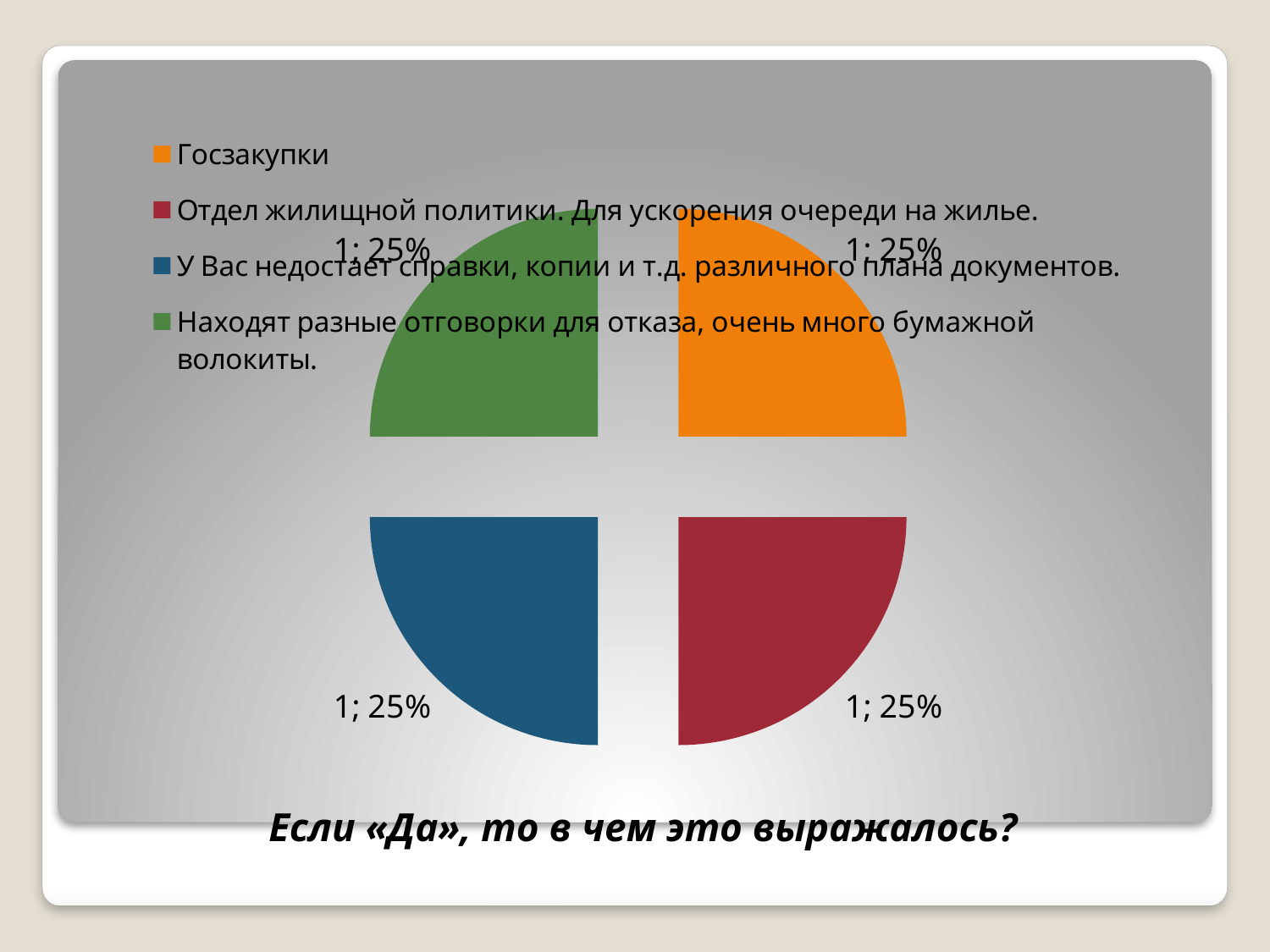
What value is printed on the data label for the «Находят разные отговорки для отказа, очень много бумажной волокиты.» slice? 1; 25% What is the title shown below the pie chart? Если «Да», то в чем это выражалось? What share of the pie does the slice for «У Вас недостает справки, копии и т.д. различного плана документов.» represent? 25% What kind of chart is shown on the slide? pie chart What share of the pie does the slice for Госзакупки represent? 25% What is the total of the values across all four slices of the pie chart? 4 How many slices does the pie chart have? 4 What value is printed on the data label for the Госзакупки slice? 1; 25% What share of the pie does the slice for «Находят разные отговорки для отказа, очень много бумажной волокиты.» represent? 25% How many entries does the legend of the pie chart list? 4 What colour is the slice for Госзакупки in the pie chart? orange